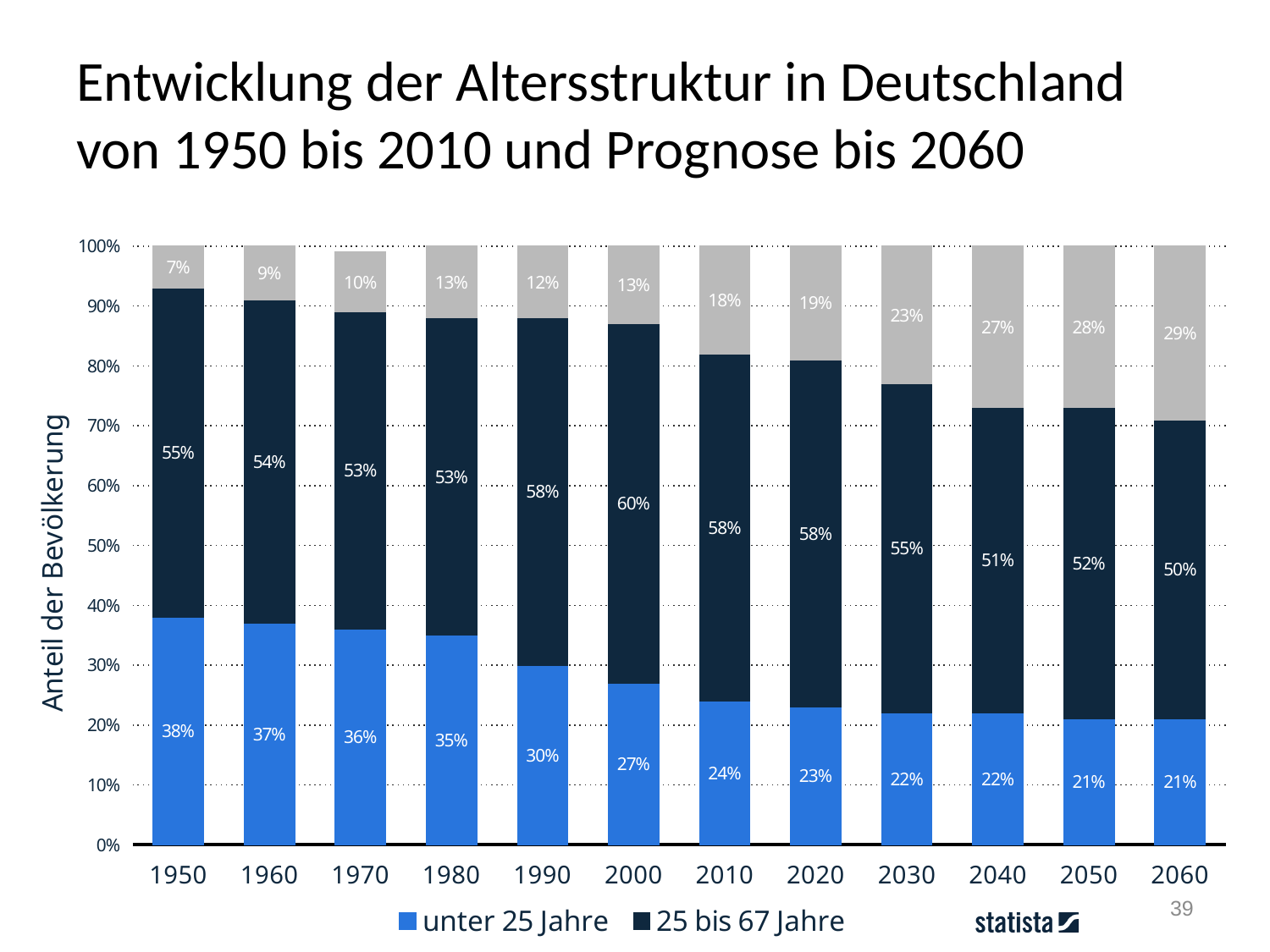
In which year is the share of "unter 25 Jahre" highest? 1950 What is the value for "25 bis 67 Jahre" in 2000? 60% In which year is the share of "25 bis 67 Jahre" highest? 2000 How many series does the legend list? 2 How many years are shown on the x axis? 12 Which year has the larger share of "25 bis 67 Jahre": 1990 or 2030? 1990 What kind of chart is shown on the slide? Stacked bar chart Does the share of "unter 25 Jahre" rise or fall from 1950 to 2060? Fall In which year is the share of "25 bis 67 Jahre" lowest? 2060 What is the value for "unter 25 Jahre" in 2060? 21% What is the value for "unter 25 Jahre" in 1950? 38% By how many percentage points does the "unter 25 Jahre" share in 1950 exceed that in 2060? 17 percentage points